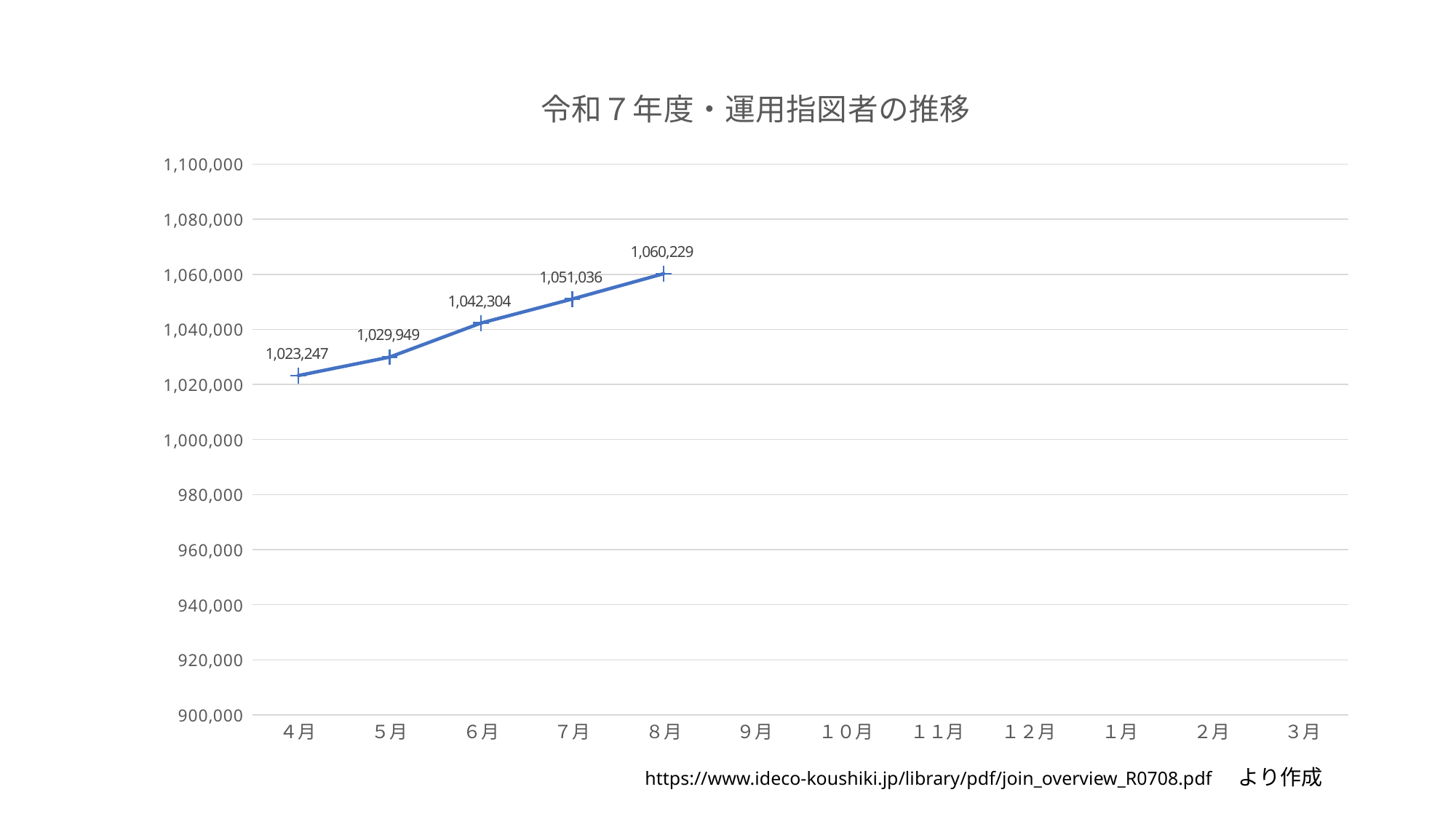
What is the value for 8月? 1,060,229 How many months have a plotted data point on the chart? 5 Which is larger, the value for 7月 or the value for 5月? 7月 What is the value for 6月? 1,042,304 Which month has the lowest plotted value? 4月 Which month has the highest plotted value? 8月 What is the value for 4月? 1,023,247 What is the difference between the values for 8月 and 4月? 36,982 What is the title of the chart? 令和７年度・運用指図者の推移 What type of chart is shown on the slide? line chart Do the plotted values rise or fall from 4月 to 8月? rise What is the difference between the values for 6月 and 5月? 12,355